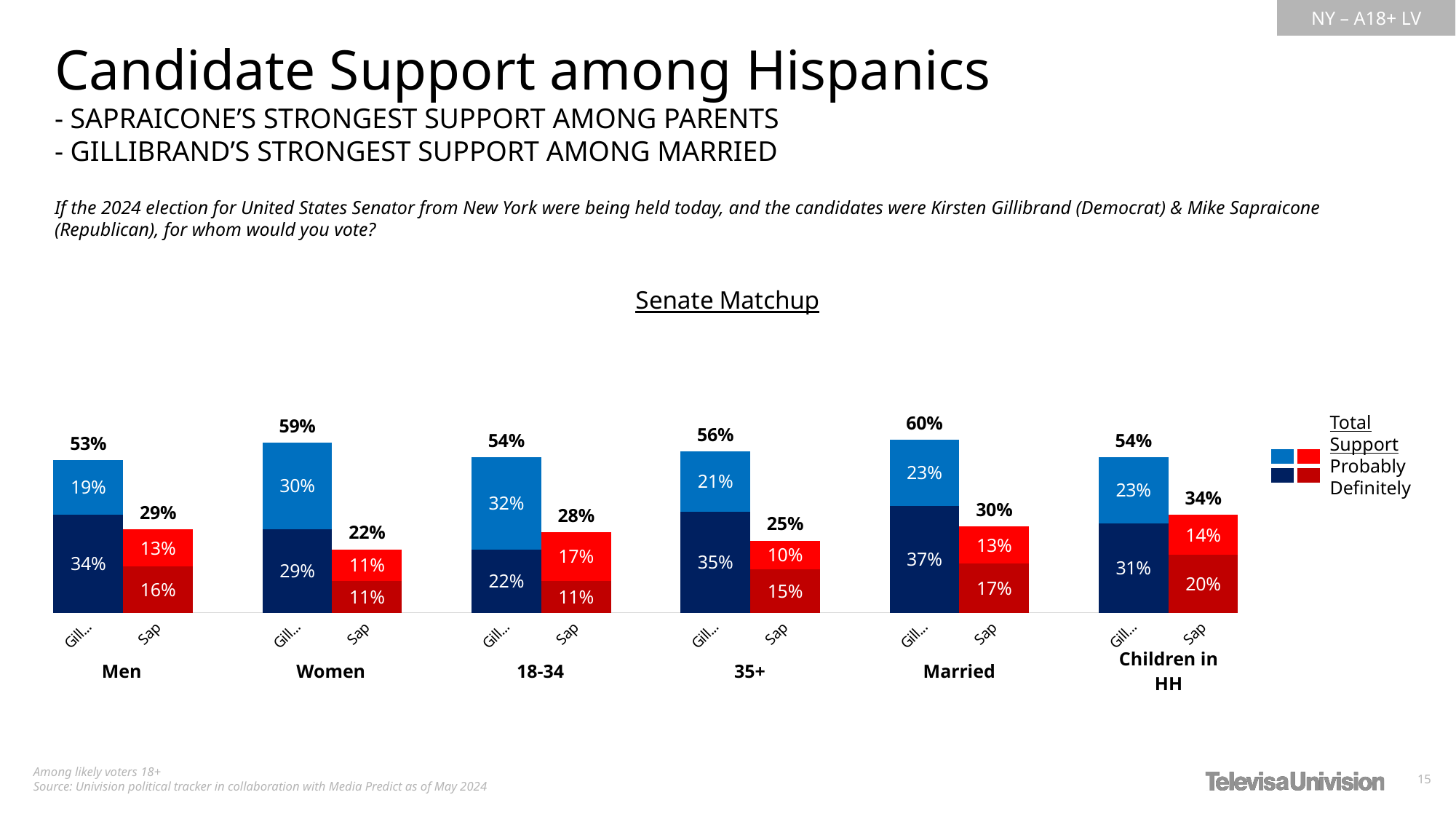
Among which demographic group is Gillibrand's total support highest? Married Which two levels of support does the legend distinguish? Probably and Definitely How many demographic groups are shown on the chart? 6 What is the sum of the Definitely and Probably segments for Sapraicone among Married Hispanic voters? 30% Among Hispanic voters aged 35+, which candidate has higher total support, Gillibrand or Sapraicone? Gillibrand What is the total support for Sapraicone among Hispanic voters with Children in HH? 34% What share of Hispanic Women say they would definitely vote for Gillibrand? 29% Among which demographic group is Sapraicone's total support lowest? Women What share of Hispanic voters aged 18-34 say they would probably vote for Sapraicone? 17% What is the difference between Gillibrand's and Sapraicone's total support among Hispanic Men? 24 percentage points What is the total support for Gillibrand among Married Hispanic voters? 60% What type of chart is used to show the Senate Matchup? Stacked bar chart